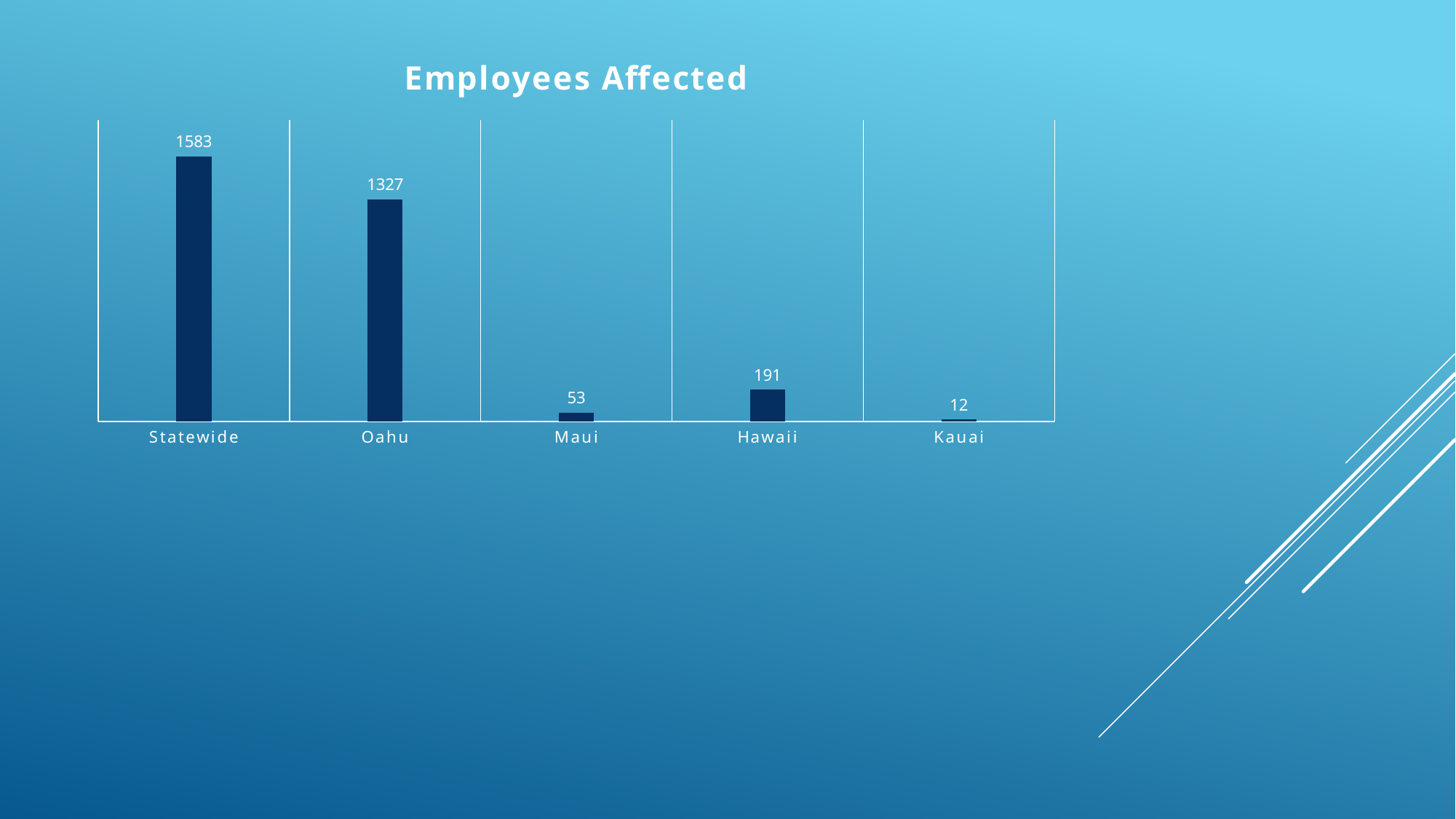
What is the difference between the values for Hawaii and Maui? 138 What is the difference between the values for Statewide and Oahu? 256 Which has a larger value, Hawaii or Maui? Hawaii What is the value for Oahu in the Employees Affected chart? 1327 How many categories are shown in the Employees Affected chart? 5 What is the value for Hawaii in the Employees Affected chart? 191 Which category has the lowest value in the Employees Affected chart? Kauai What is the value for Statewide in the Employees Affected chart? 1583 What is the value for Kauai in the Employees Affected chart? 12 What is the value for Maui in the Employees Affected chart? 53 What kind of chart is shown on the slide? Bar chart Which category has the highest value in the Employees Affected chart? Statewide